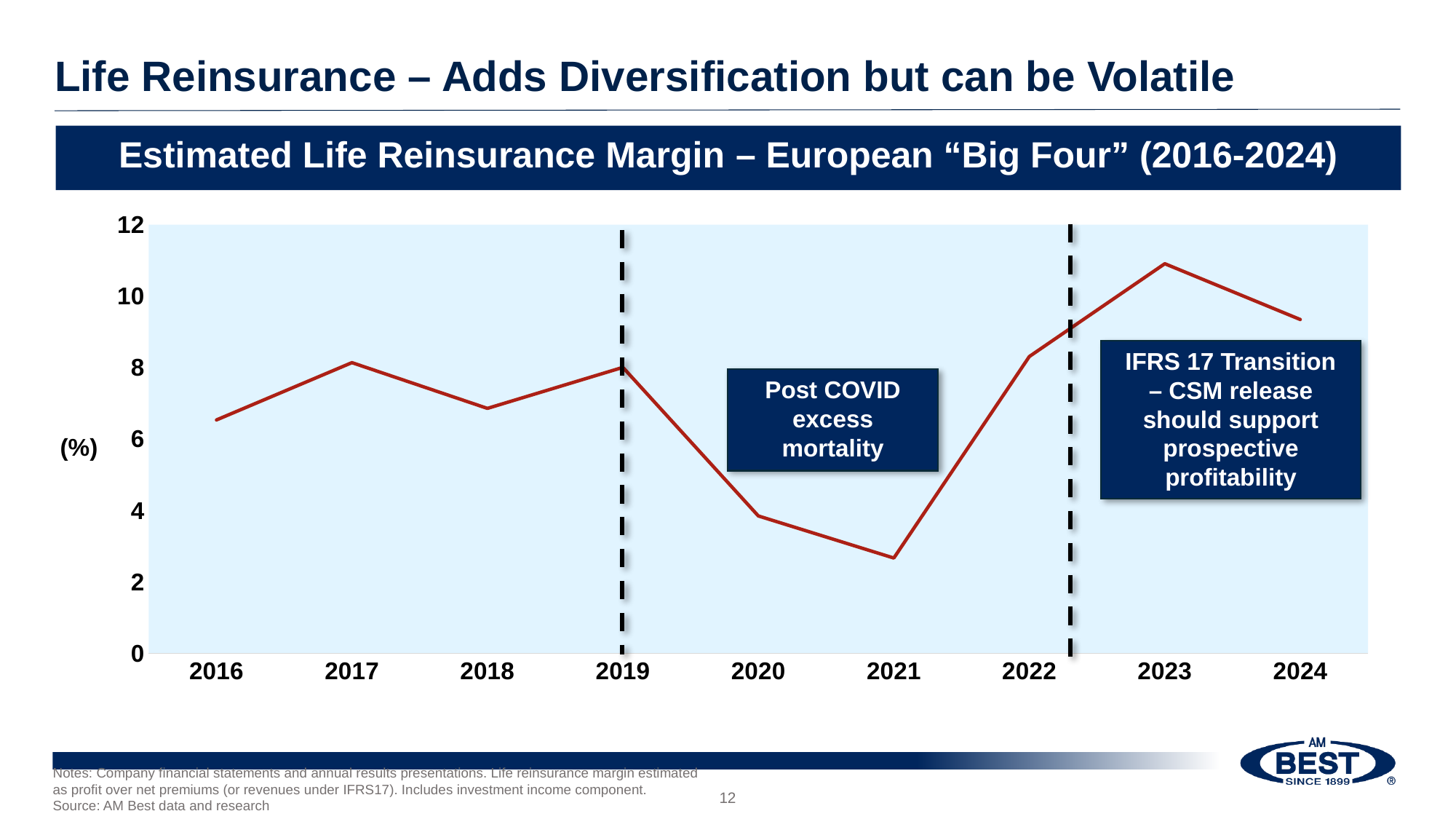
Which year has the highest estimated life reinsurance margin? 2023 Which is larger, the value for 2022 or the value for 2020? 2022 How many years are plotted along the x axis? 9 Is the value for 2020 greater or less than 6? less Which year has the lowest estimated life reinsurance margin? 2021 Is the value for 2021 greater or less than 4? less Does the margin rise or fall from 2019 to 2021? fall What is the title of the chart? Estimated Life Reinsurance Margin – European "Big Four" (2016-2024) Is the value for 2016 greater or less than 6? greater What unit is shown on the y axis label? (%) What kind of chart is shown on the slide? line chart